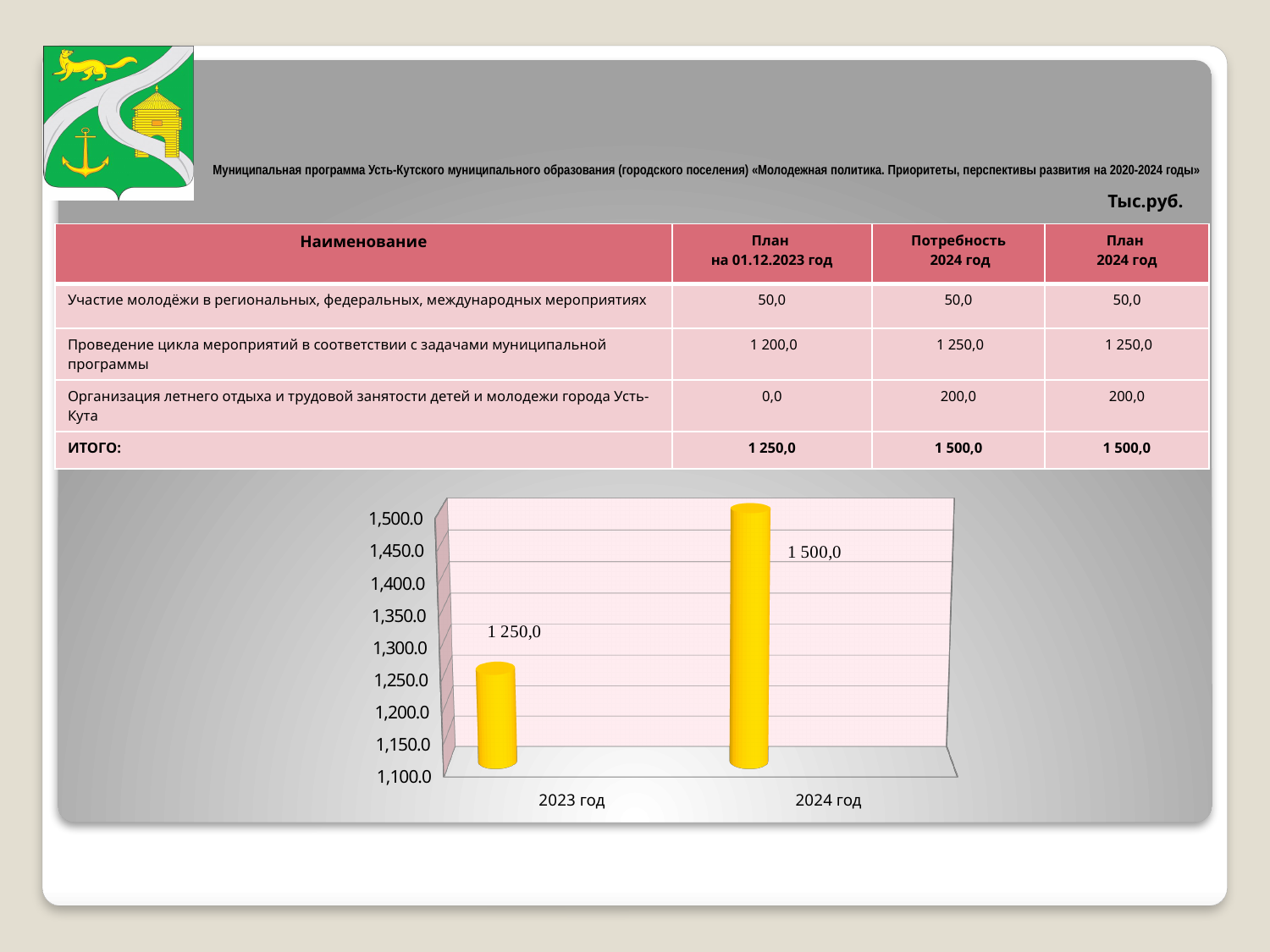
What is the difference between the values for 2024 год and 2023 год in the chart? 250,0 Is the value for 2024 год greater or less than 1,400.0? greater How many categories are plotted in the chart? 2 What colour are the bars in the chart? yellow What is the lowest value shown on the chart's vertical axis? 1,100.0 Which year has the higher value in the chart? 2024 год Is the value for 2023 год greater or less than 1,300.0? less Which year has the lower value in the chart? 2023 год What is the value shown for 2024 год in the chart? 1 500,0 What is the value shown for 2023 год in the chart? 1 250,0 What kind of chart is shown on the slide? bar chart Do the values rise or fall from 2023 год to 2024 год in the chart? rise